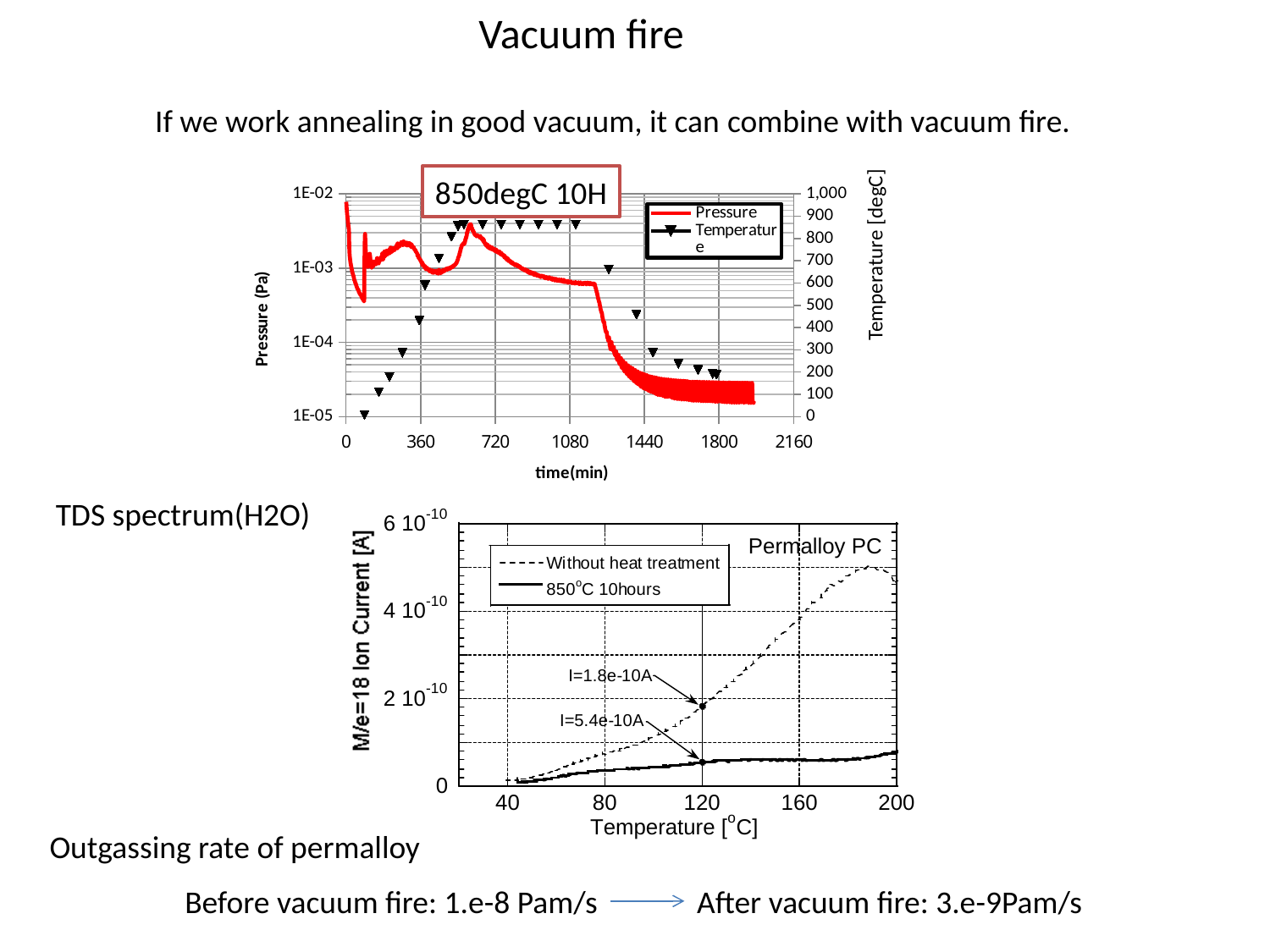
In the top chart, is the pressure at 1800 min greater or less than 1E-04 Pa? less In the bottom chart (TDS spectrum), is the 'Without heat treatment' ion current at 160°C greater or less than 2 10^-10 A? greater In the top chart, what are the two series named in the legend? Pressure and Temperature In the top chart (pressure and temperature vs time), how many series does the legend list? 2 In the bottom chart (TDS spectrum), what is the labelled ion current of the 'Without heat treatment' curve at 120°C? I=1.8e-10A In the top chart, what is the label on the x axis? time(min) In the top chart, is the temperature at 720 min greater or less than 500 degC? greater In the bottom chart (TDS spectrum), how many series does the legend list? 2 What kind of chart is the top chart showing pressure and temperature against time? Line chart In the bottom chart (TDS spectrum), does the 'Without heat treatment' curve rise or fall between 40°C and 160°C? rise In the bottom chart (TDS spectrum), at 120°C which series has the higher ion current, 'Without heat treatment' or '850°C 10hours'? Without heat treatment